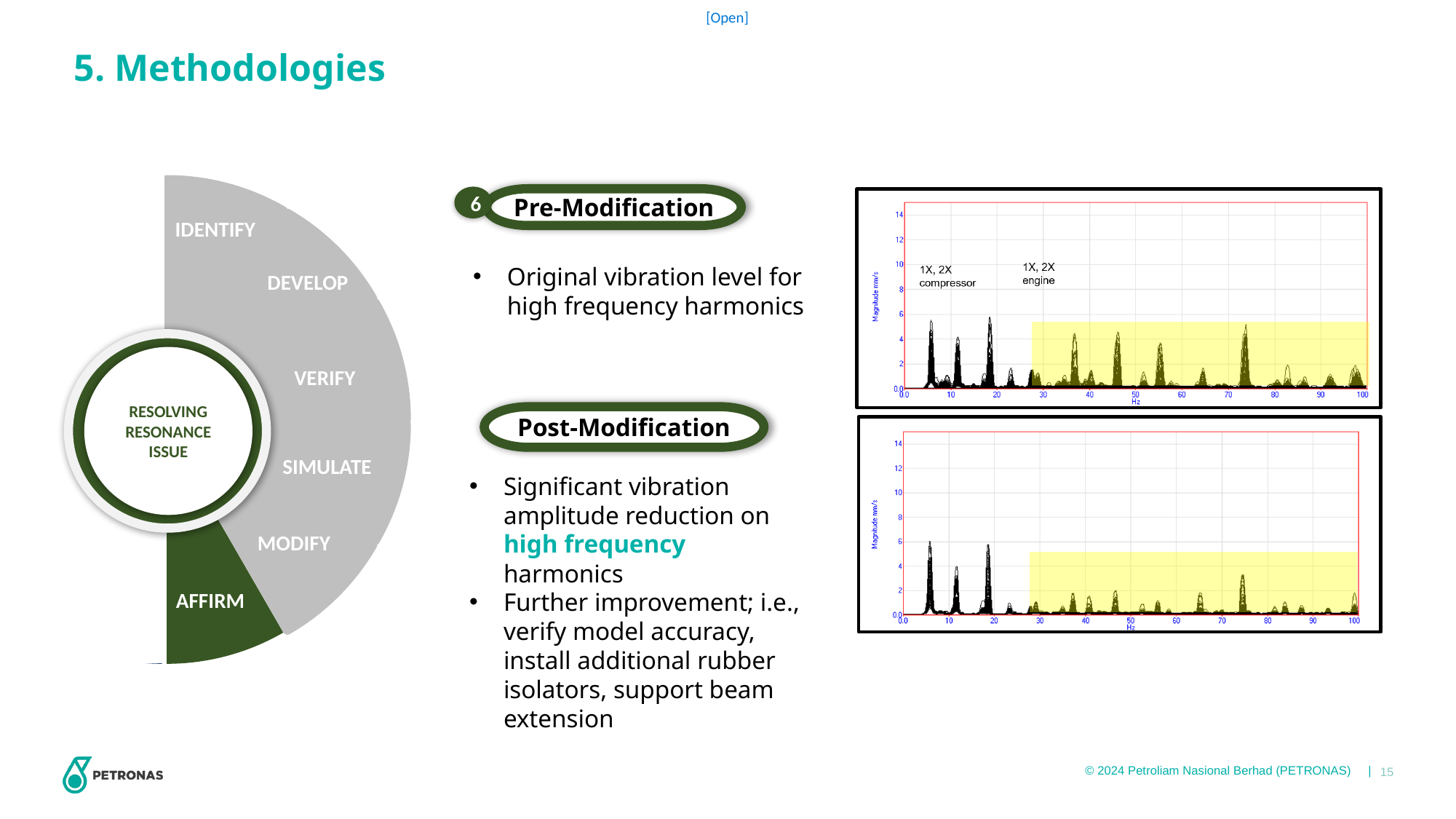
Which chart shows the larger peak near 46 Hz, the Pre-Modification chart or the Post-Modification chart? Pre-Modification In the Pre-Modification chart, is the peak near 5 Hz greater or less than 4? greater Which chart shows the larger peak near 37 Hz, the Pre-Modification chart or the Post-Modification chart? Pre-Modification In the Post-Modification chart, is the peak near 37 Hz greater or less than 2? less What kind of chart is the Pre-Modification chart (top right)? line chart In the Post-Modification chart, what is the label on the y axis? Magnitude mm/s In the Post-Modification chart, is the peak near 19 Hz greater or less than 4? greater In the Pre-Modification chart, what is the label on the x axis? Hz